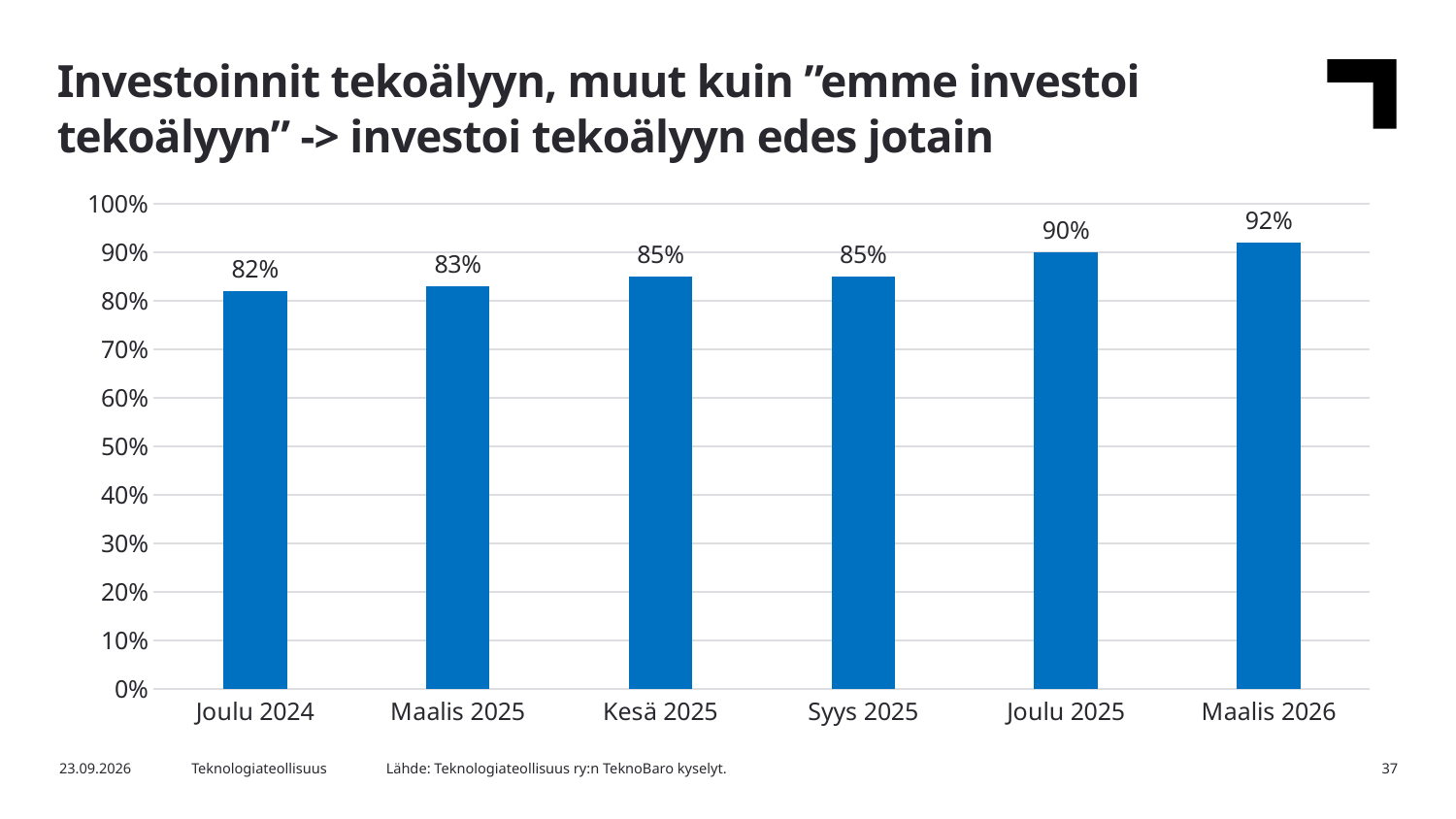
What is the difference between the values for Joulu 2025 and Syys 2025? 5% What is the value for Maalis 2026? 92% Is the value for Joulu 2025 greater or less than 80%? greater Do the values rise or fall from Joulu 2024 to Maalis 2026? rise Which category has the lowest value? Joulu 2024 How many categories are shown on the x axis? 6 What kind of chart is shown on the slide? bar chart Which is larger, the value for Maalis 2025 or the value for Joulu 2025? Joulu 2025 What is the value for Joulu 2024? 82% What is the value for Kesä 2025? 85% What is the difference between the values for Maalis 2026 and Joulu 2024? 10% Which category has the highest value? Maalis 2026